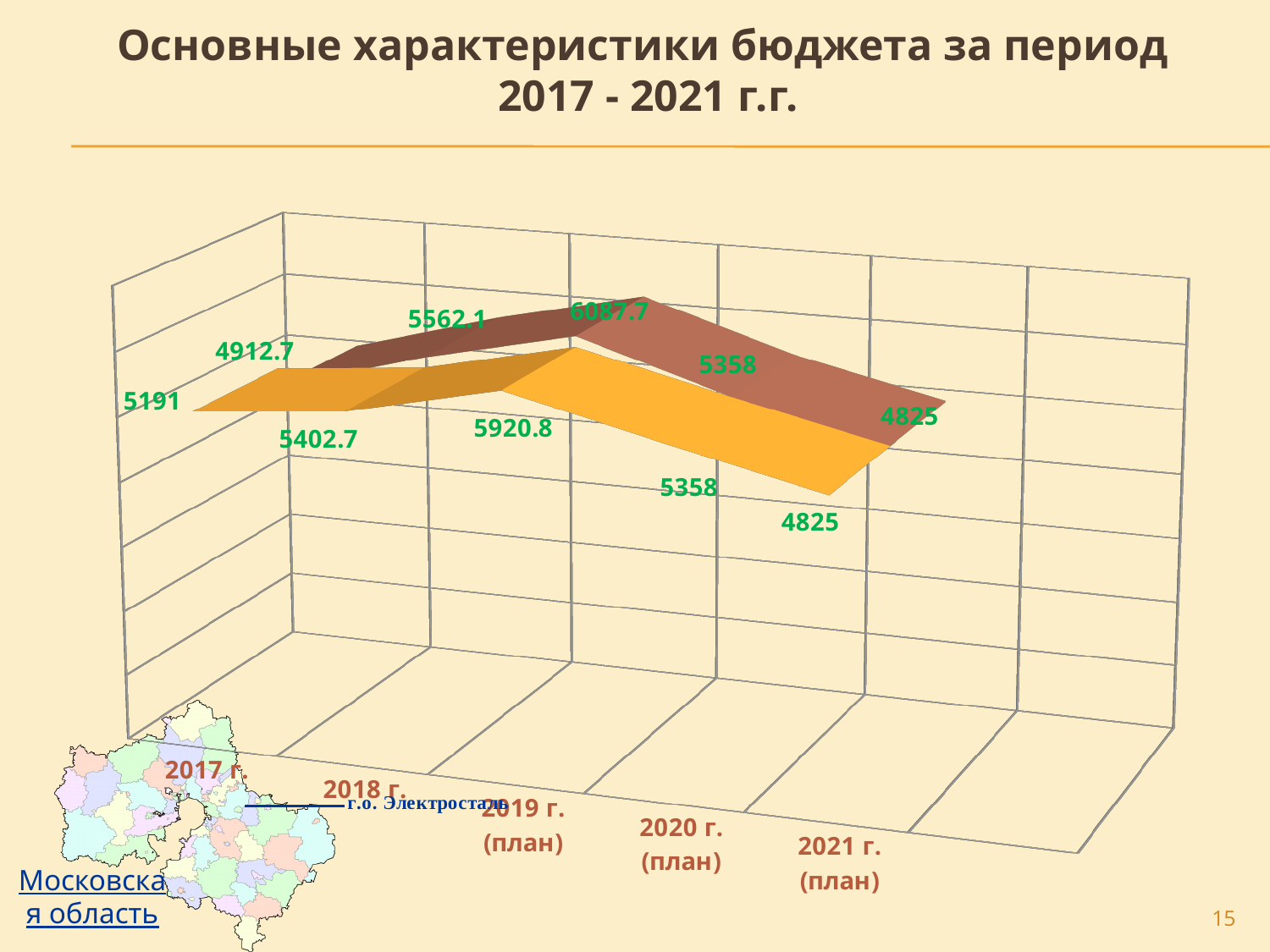
What is the value of the front (yellow) series for 2019 г. (план)? 5920.8 What kind of chart is shown on the slide? 3D line chart What is the difference between the back (brown) series and the front (yellow) series for 2019 г. (план)? 166.9 Which is larger for 2018 г.: the front (yellow) series value or the back (brown) series value? the back (brown) series What is the value of the back (brown) series for 2017 г.? 4912.7 What is the value of the front (yellow) series for 2021 г. (план)? 4825 What is the value of the back (brown) series for 2019 г. (план)? 6087.7 What is the title of the chart on the slide? Основные характеристики бюджета за период 2017 - 2021 г.г. What is the value of the front (yellow) series for 2017 г.? 5191 In which year does the back (brown) series reach its highest value? 2019 г. (план) In which year does the front (yellow) series have its lowest value? 2021 г. (план) How many year categories are shown along the x axis of the chart? 5